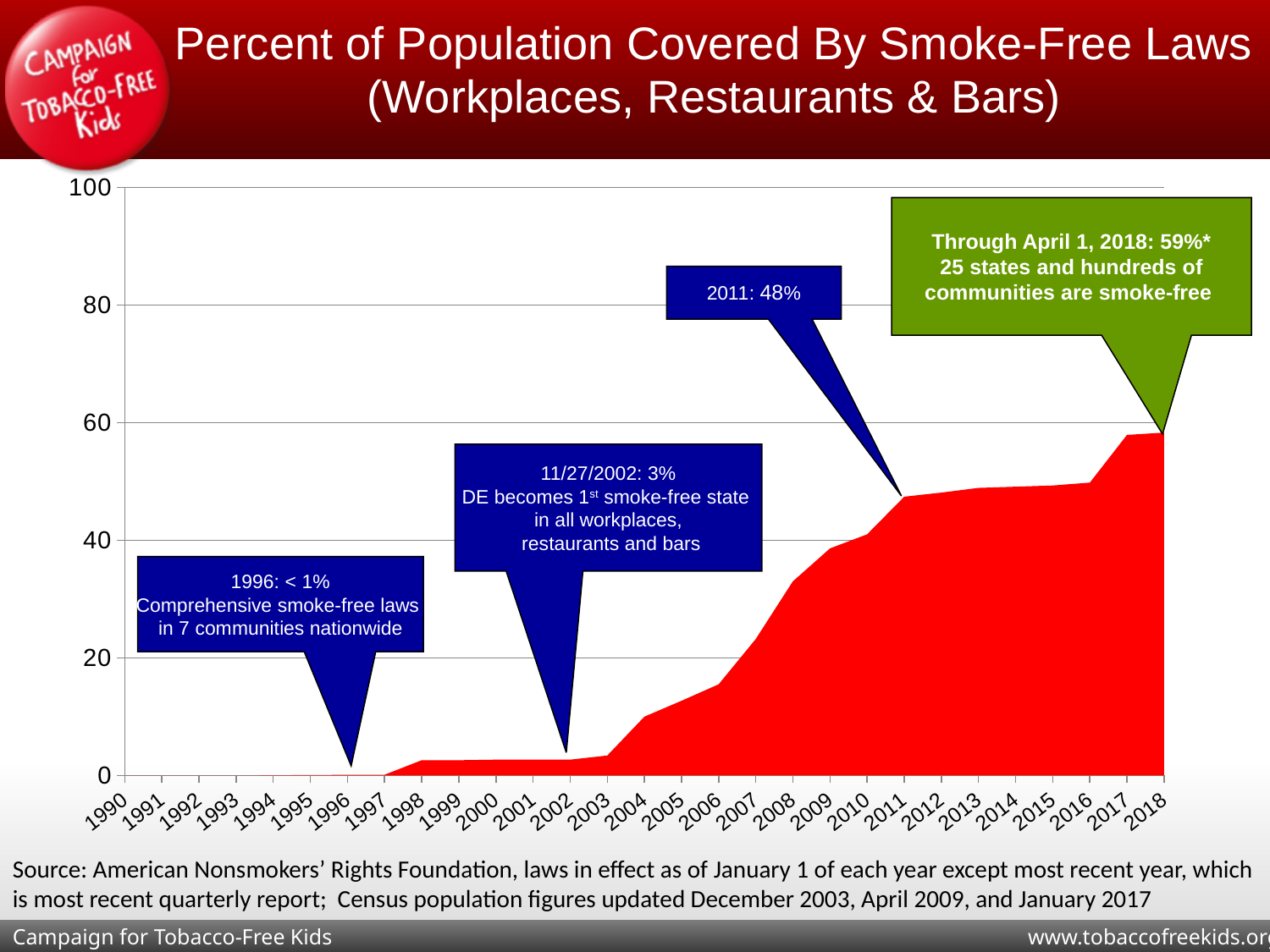
Which is larger: the coverage in 2011 or the coverage on 11/27/2002? 2011 Does the percent of population covered rise or fall from 1990 to 2018? Rise What percent of the population was covered on 11/27/2002, according to the callout? 3% How many years are labeled on the x axis? 29 Is the value for 2008 greater or less than 40? less Is the value for 2005 greater or less than 20? less By how many percentage points did coverage increase from 2011 (48%) to April 1, 2018 (59%)? 11 Is the value for 2014 greater or less than 40? greater What percent of the population was covered by smoke-free laws in 2011, according to the callout? 48% Which year on the x axis has the highest percent of population covered? 2018 What kind of chart is shown on the slide? Area chart What percent of the population was covered through April 1, 2018, according to the callout? 59%